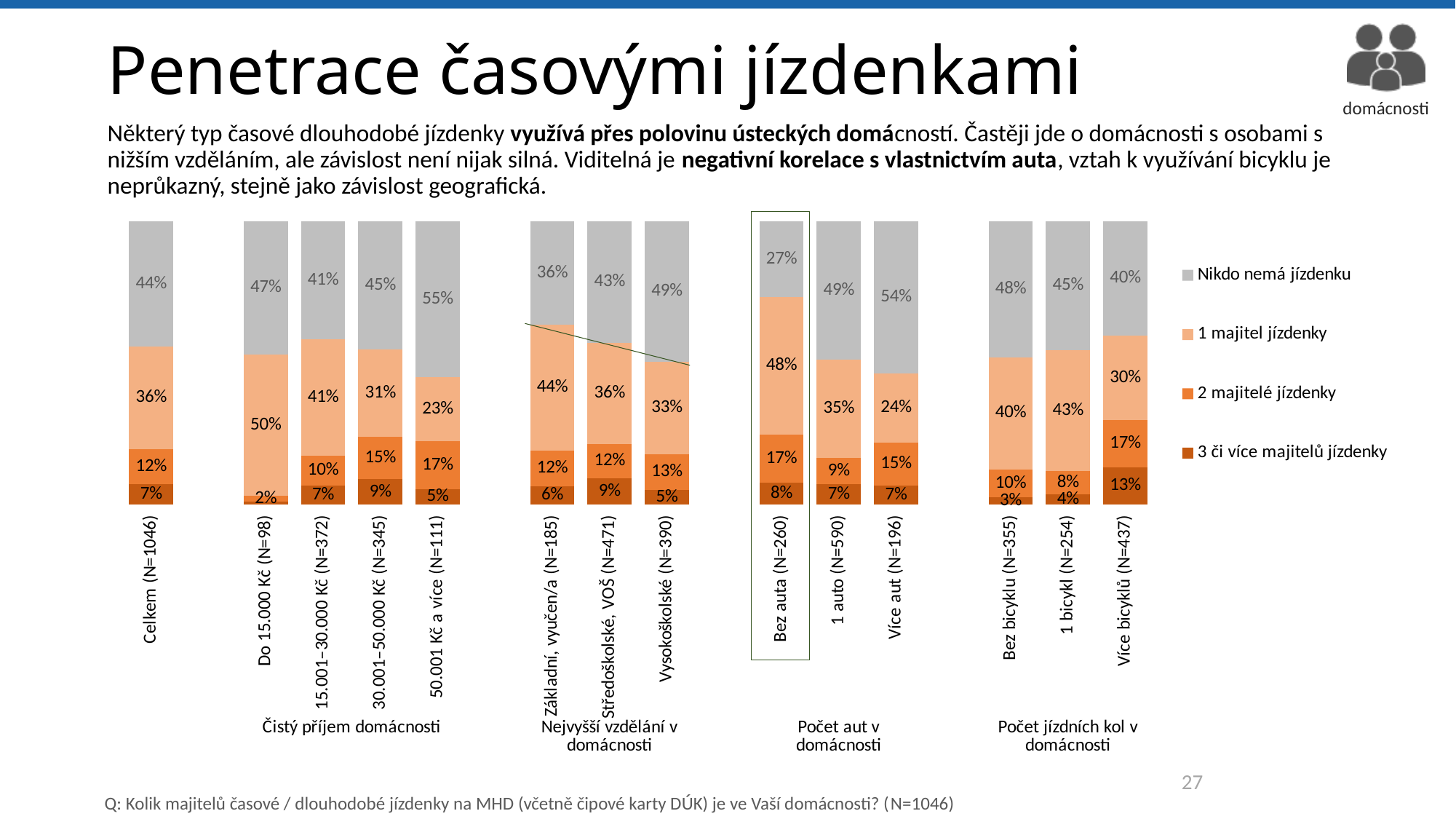
What is the difference between the "Nikdo nemá jízdenku" values for Více aut (N=196) and Bez auta (N=260)? 27% Which legend entry is shown in grey? Nikdo nemá jízdenku What is the value of "1 majitel jízdenky" for Bez auta (N=260)? 48% How many series does the chart legend list? 4 What is the value of "3 či více majitelů jízdenky" for Více bicyklů (N=437)? 13% What is the value of "Nikdo nemá jízdenku" for Celkem (N=1046)? 44% What is the value of "2 majitelé jízdenky" for 1 auto (N=590)? 9% What kind of chart is shown on the slide? stacked bar chart Which is larger: the "1 majitel jízdenky" value for Základní, vyučen/a (N=185) or for Vysokoškolské (N=390)? Základní, vyučen/a (N=185) Which category has the highest value of "Nikdo nemá jízdenku"? 50.001 Kč a více (N=111) Which category has the lowest value of "Nikdo nemá jízdenku"? Bez auta (N=260) How many bars (categories) are plotted in the chart? 14